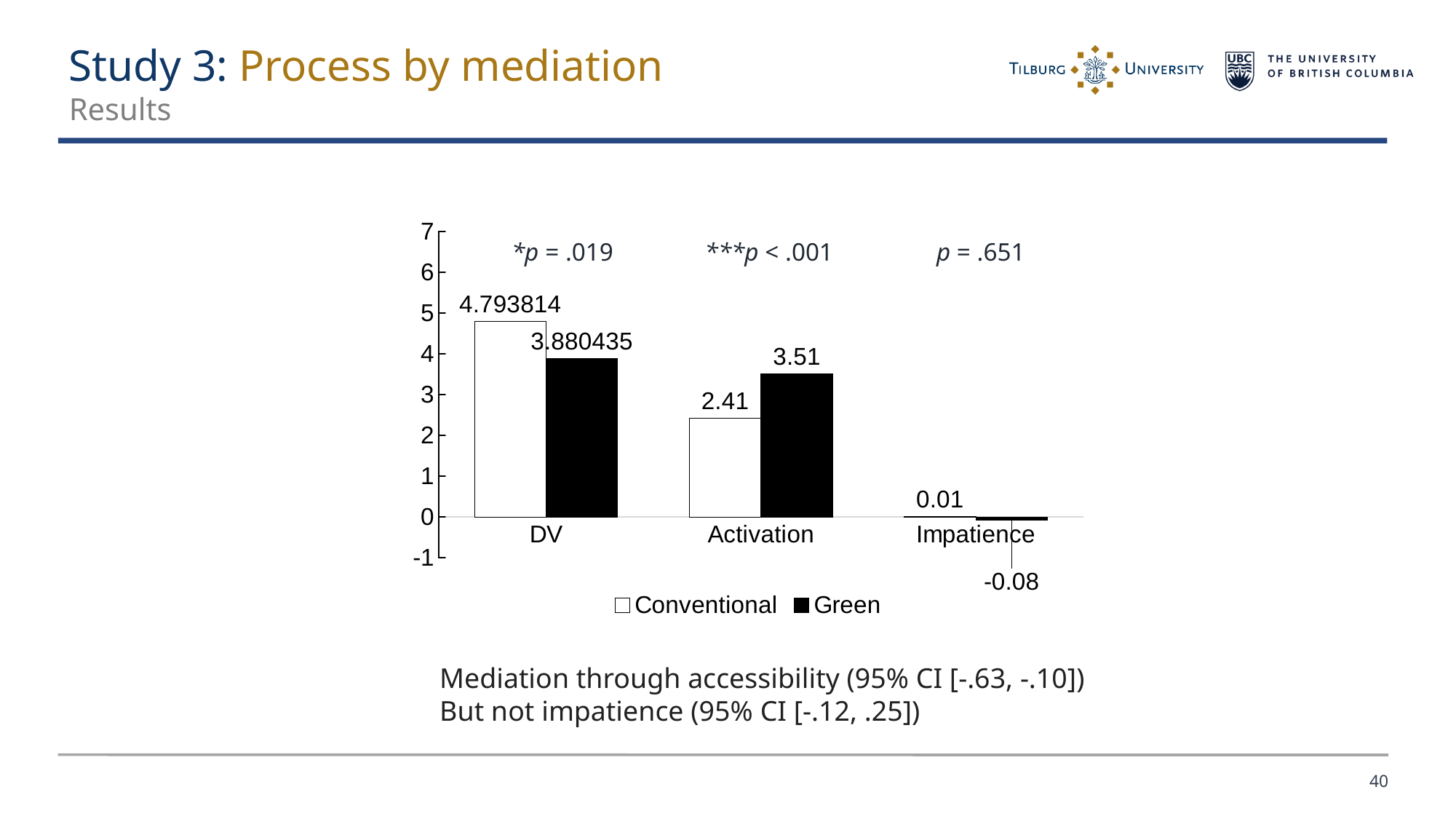
What is the Green value for Impatience? -0.08 What is the difference between the Green and Conventional values for Activation? 1.1 What is the Conventional value for Impatience? 0.01 Is the Green value for DV greater or less than 3? greater Which category has the highest Conventional value? DV How many series does the legend list? 2 What is the Conventional value for DV? 4.793814 How many categories are shown on the x axis? 3 For DV, which series has the larger value, Conventional or Green? Conventional Which category has the lowest Green value? Impatience What kind of chart is shown on the slide? bar chart What is the Green value for Activation? 3.51